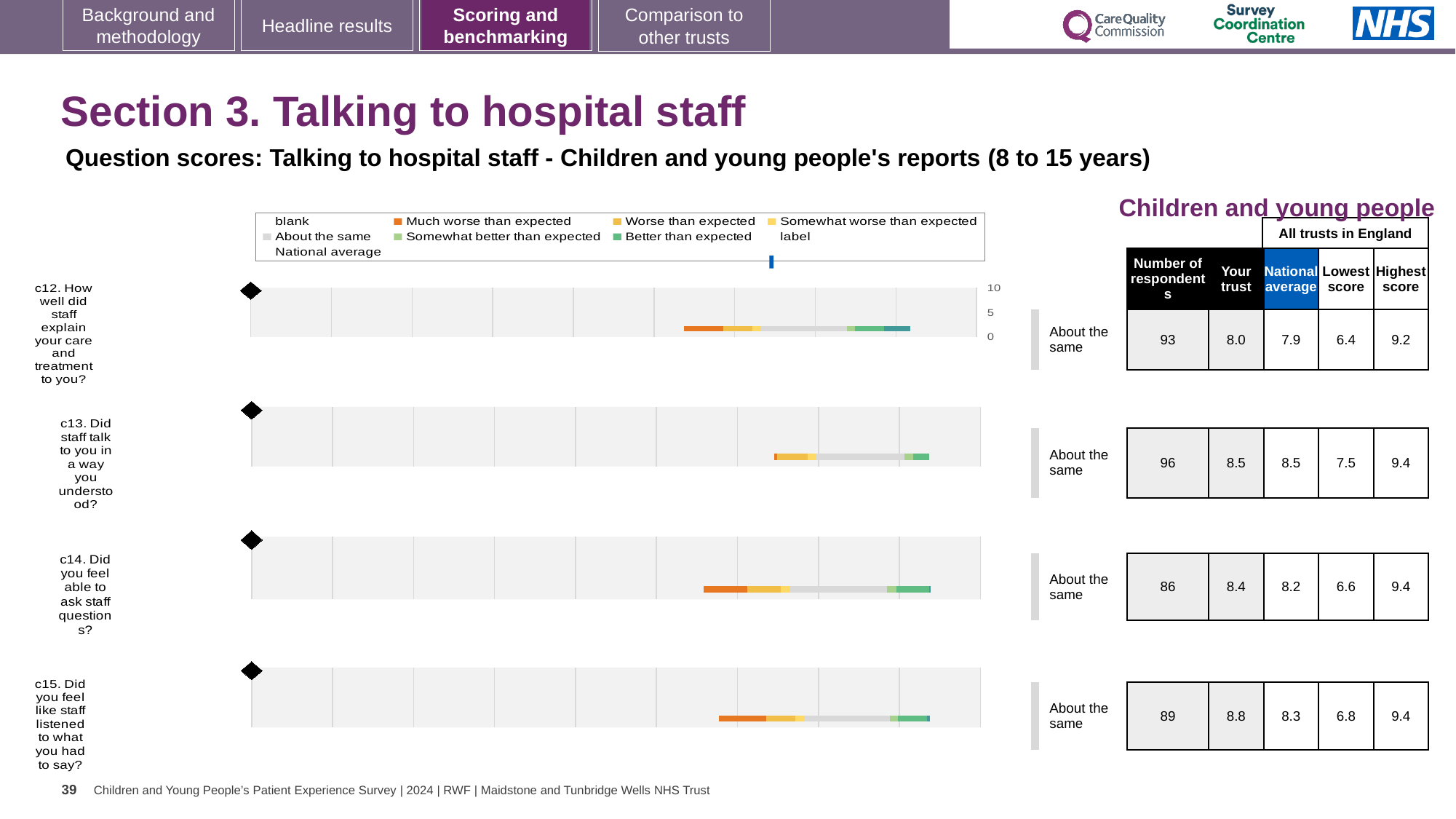
What is the highest score among all trusts in England for c12? 9.2 How many questions (c12 to c15) have a chart on this slide? 4 For c14, which is larger: the 'Your trust' score or the national average? Your trust What is the 'Your trust' score for c12 (How well did staff explain your care and treatment to you?)? 8.0 What benchmark category is shown next to the chart for c13? About the same How many respondents answered c13 (Did staff talk to you in a way you understood?)? 96 Which question has the highest 'Your trust' score? c15 What is the national average score for c15 (Did you feel like staff listened to what you had to say?)? 8.3 For c15, what is the difference between the 'Your trust' score and the national average? 0.5 What kind of chart is used to show the question scores for c12 to c15? bar chart Which question has the lowest 'Your trust' score? c12 What is the lowest score among all trusts in England for c14? 6.6